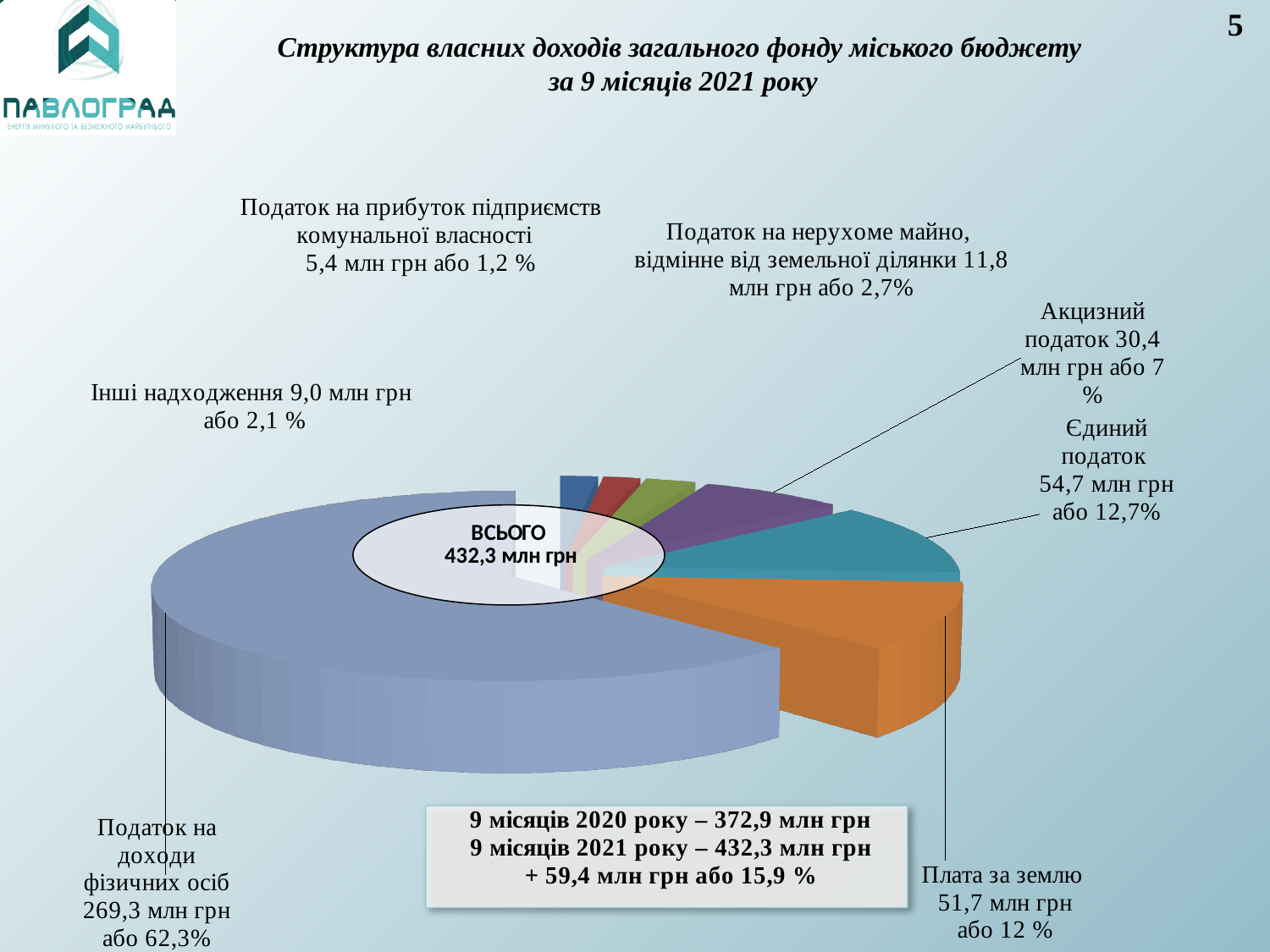
What share of the pie does Акцизний податок represent? 7 % Which category has the largest slice of the pie? Податок на доходи фізичних осіб Which category has the smallest slice of the pie? Податок на прибуток підприємств комунальної власності What type of chart is shown on the slide? Pie chart How many slices does the pie chart have? 7 What is the value for Податок на доходи фізичних осіб? 269,3 млн грн Which is larger: Єдиний податок or Плата за землю? Єдиний податок What is the value for Податок на нерухоме майно, відмінне від земельної ділянки? 11,8 млн грн What share of the pie does Єдиний податок represent? 12,7% What is the value for Плата за землю? 51,7 млн грн What total (ВСЬОГО) is shown in the centre of the pie chart? 432,3 млн грн What is the difference in млн грн between Акцизний податок and Інші надходження? 21,4 млн грн